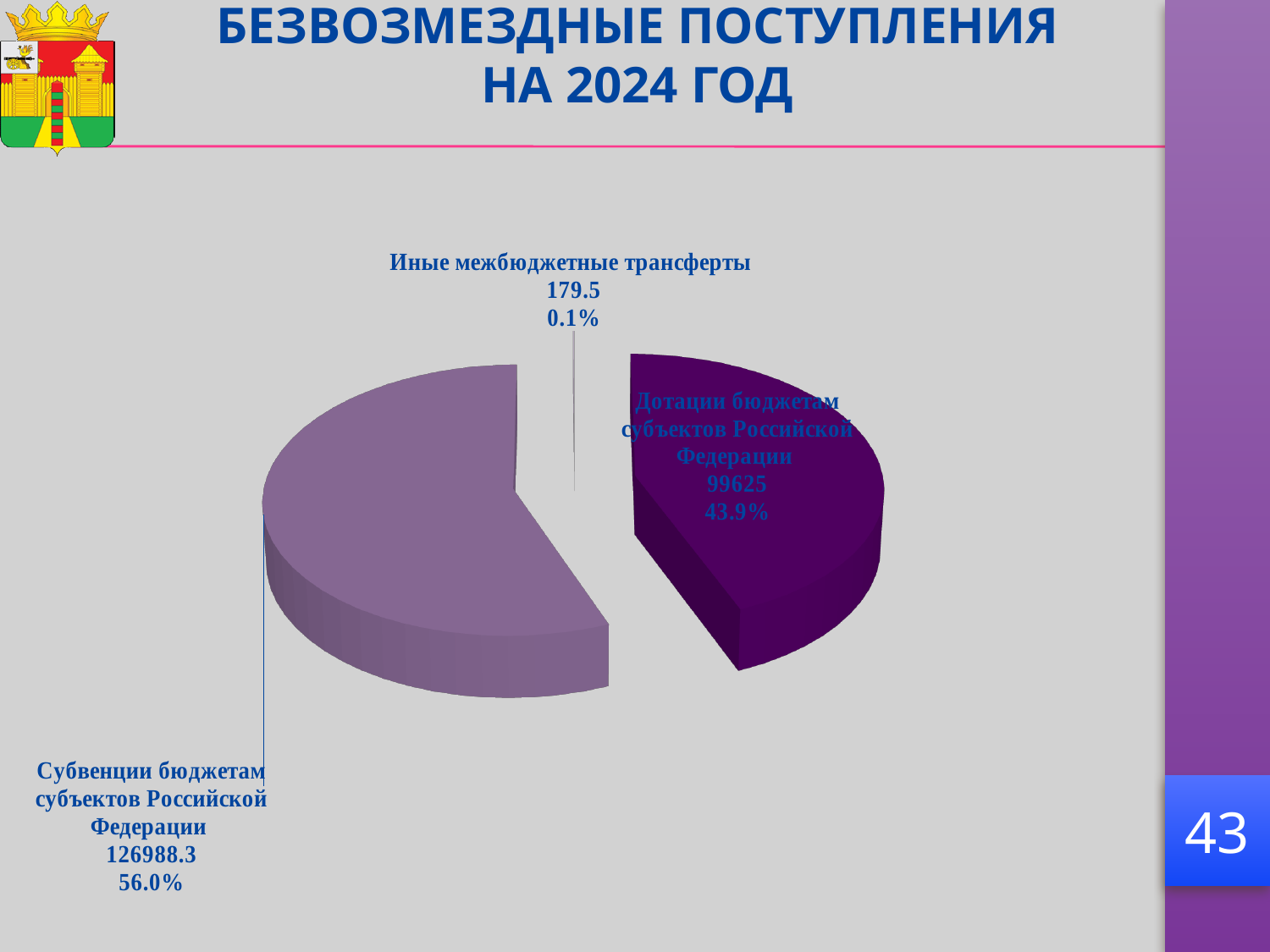
What is the value for Иные межбюджетные трансферты? 179.5 What kind of chart is shown on the slide? Pie chart What is the title of the slide containing the pie chart? БЕЗВОЗМЕЗДНЫЕ ПОСТУПЛЕНИЯ НА 2024 ГОД What share of the pie does Дотации бюджетам субъектов Российской Федерации represent? 43.9% What is the difference between the values for Субвенции бюджетам субъектов Российской Федерации and Дотации бюджетам субъектов Российской Федерации? 27363.3 Which category has the largest slice of the pie? Субвенции бюджетам субъектов Российской Федерации What is the value for Дотации бюджетам субъектов Российской Федерации? 99625 Which category has the smallest slice of the pie? Иные межбюджетные трансферты What share of the pie does Субвенции бюджетам субъектов Российской Федерации represent? 56.0% What share of the pie does Иные межбюджетные трансферты represent? 0.1% How many slices does the pie chart have? 3 What is the value for Субвенции бюджетам субъектов Российской Федерации? 126988.3